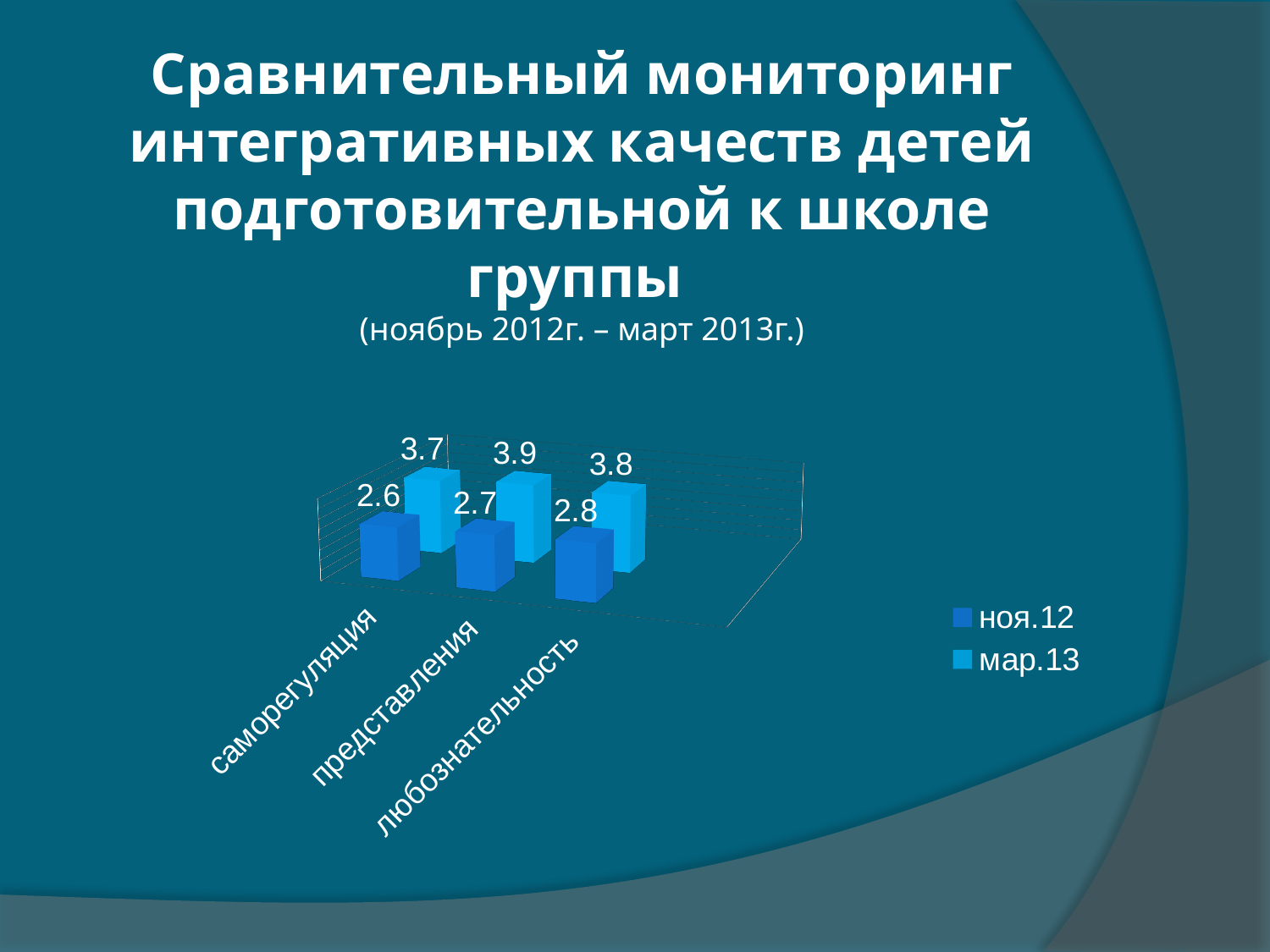
What is the difference between the мар.13 and ноя.12 values for любознательность? 1 How many categories are shown on the chart? 3 What is the difference between the мар.13 and ноя.12 values for представления? 1.2 Which is larger for саморегуляция: the ноя.12 value or the мар.13 value? мар.13 Which category has the lowest value in the ноя.12 series? саморегуляция Which category has the highest value in the мар.13 series? представления What is the value for любознательность in the ноя.12 series? 2.8 What kind of chart is shown on the slide? bar chart How many series does the legend list? 2 What is the value for представления in the мар.13 series? 3.9 What is the value for саморегуляция in the мар.13 series? 3.7 What is the value for саморегуляция in the ноя.12 series? 2.6